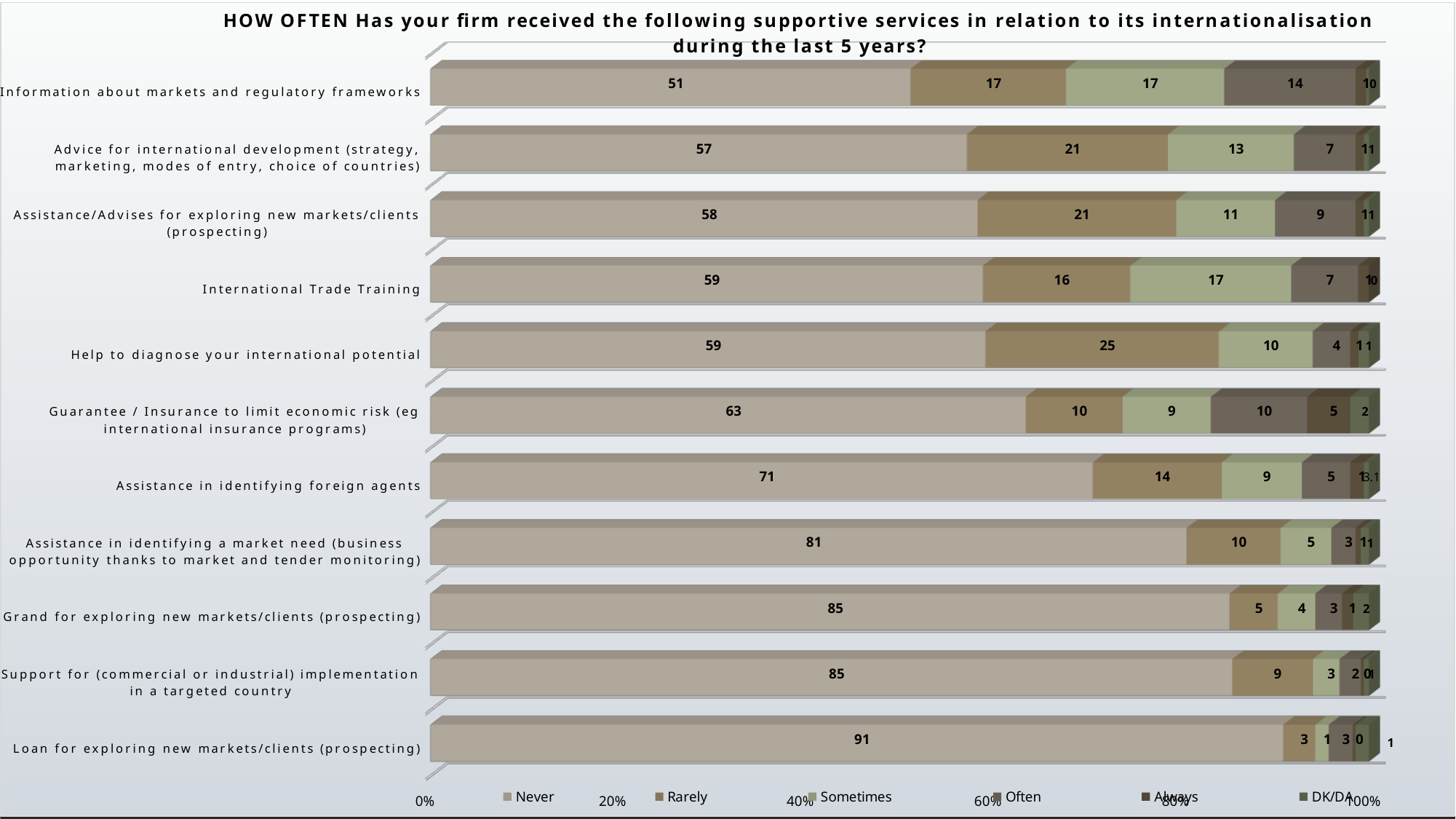
What is the 'Often' value for 'Information about markets and regulatory frameworks'? 14 Which service has the highest 'Never' value? Loan for exploring new markets/clients (prospecting) What kind of chart is shown on the slide? Stacked bar chart What is the 'Never' value for 'Loan for exploring new markets/clients (prospecting)'? 91 What is the difference between the 'Never' value for 'Loan for exploring new markets/clients (prospecting)' and the 'Never' value for 'Information about markets and regulatory frameworks'? 40 What is the first entry in the chart's legend? Never Which has the larger 'Rarely' value: 'Advice for international development' or 'International Trade Training'? Advice for international development What is the 'Sometimes' value for 'International Trade Training'? 17 Which service has the lowest 'Never' value? Information about markets and regulatory frameworks How many series does the legend list? 6 How many supportive services (categories) are plotted on the chart? 11 What is the 'Rarely' value for 'Help to diagnose your international potential'? 25